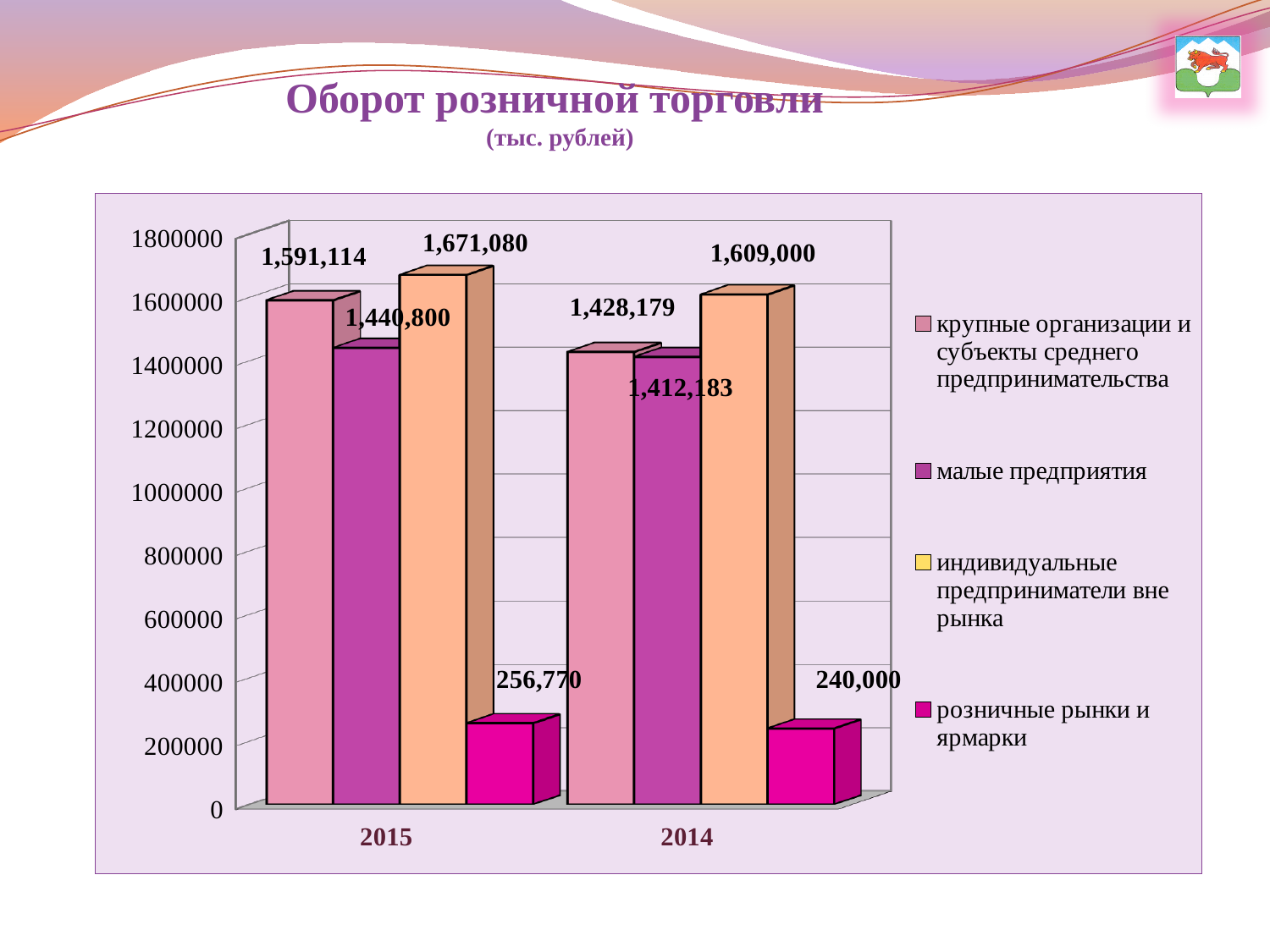
What is the difference between the value for розничные рынки и ярмарки in 2015 and in 2014? 16,770 What kind of chart is shown on the slide? bar chart What is the value for крупные организации и субъекты среднего предпринимательства in 2015? 1,591,114 What is the value for индивидуальные предприниматели вне рынка in 2014? 1,609,000 Which is larger: the value for малые предприятия in 2015 or in 2014? 2015 Which series has the lowest value in 2014? розничные рынки и ярмарки What is the title of the chart? Оборот розничной торговли (тыс. рублей) What is the value for розничные рынки и ярмарки in 2015? 256,770 How many series does the legend list? 4 What is the value for малые предприятия in 2014? 1,412,183 How many categories are shown on the x axis? 2 Which series has the highest value in 2015? индивидуальные предприниматели вне рынка